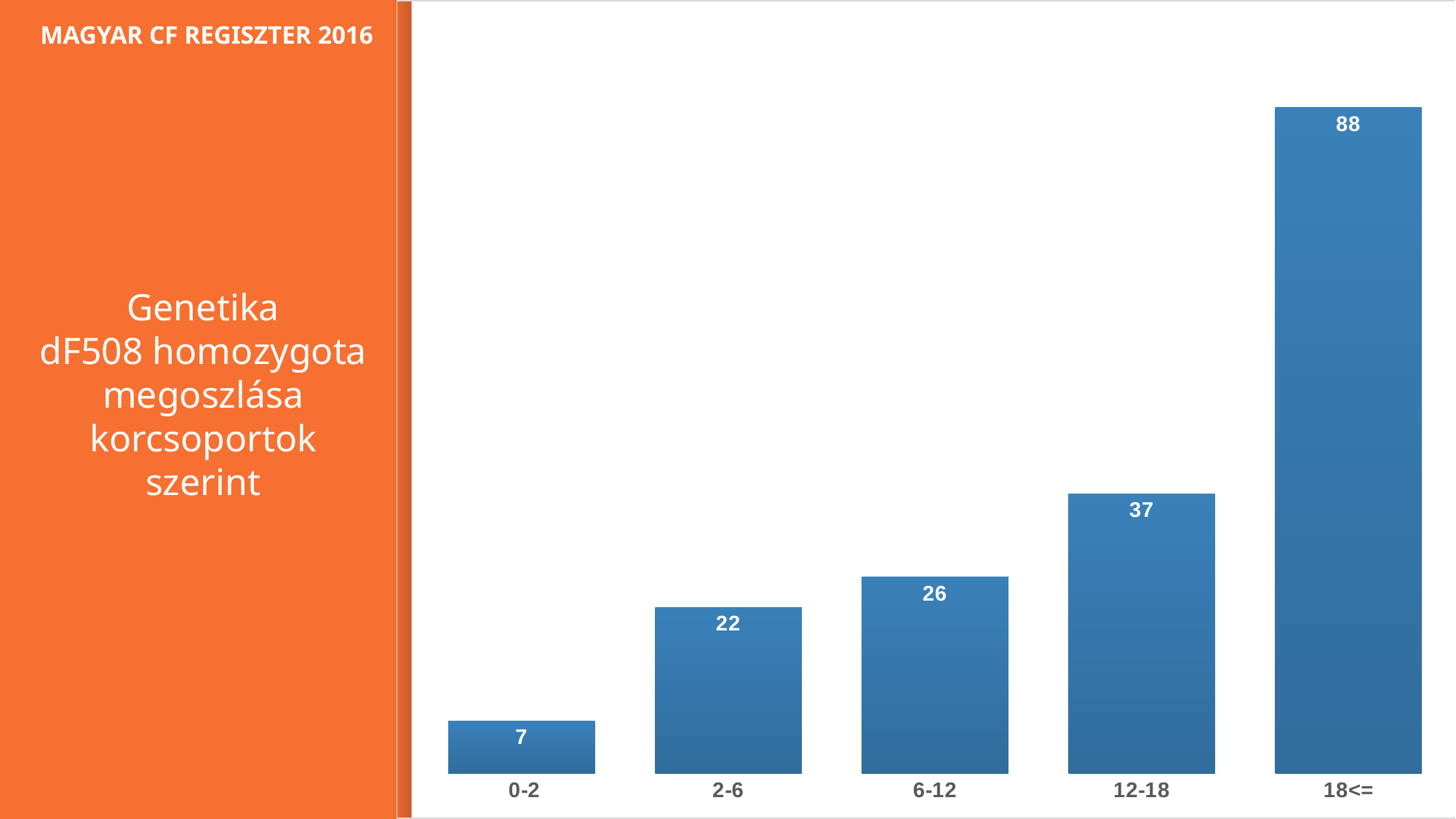
What is the difference between the values for the 18<= and 12-18 age groups? 51 What is the value for the 6-12 age group? 26 What is the value for the 2-6 age group? 22 What is the value for the 18<= age group? 88 How many age groups are shown in the chart? 5 Which age group has the highest value? 18<= What is the value for the 0-2 age group? 7 What kind of chart is shown on the slide? Bar chart What is the value for the 12-18 age group? 37 Which age group has the lowest value? 0-2 Which is larger, the value for 2-6 or the value for 6-12? 6-12 Do the values rise or fall from the 0-2 group to the 18<= group? Rise